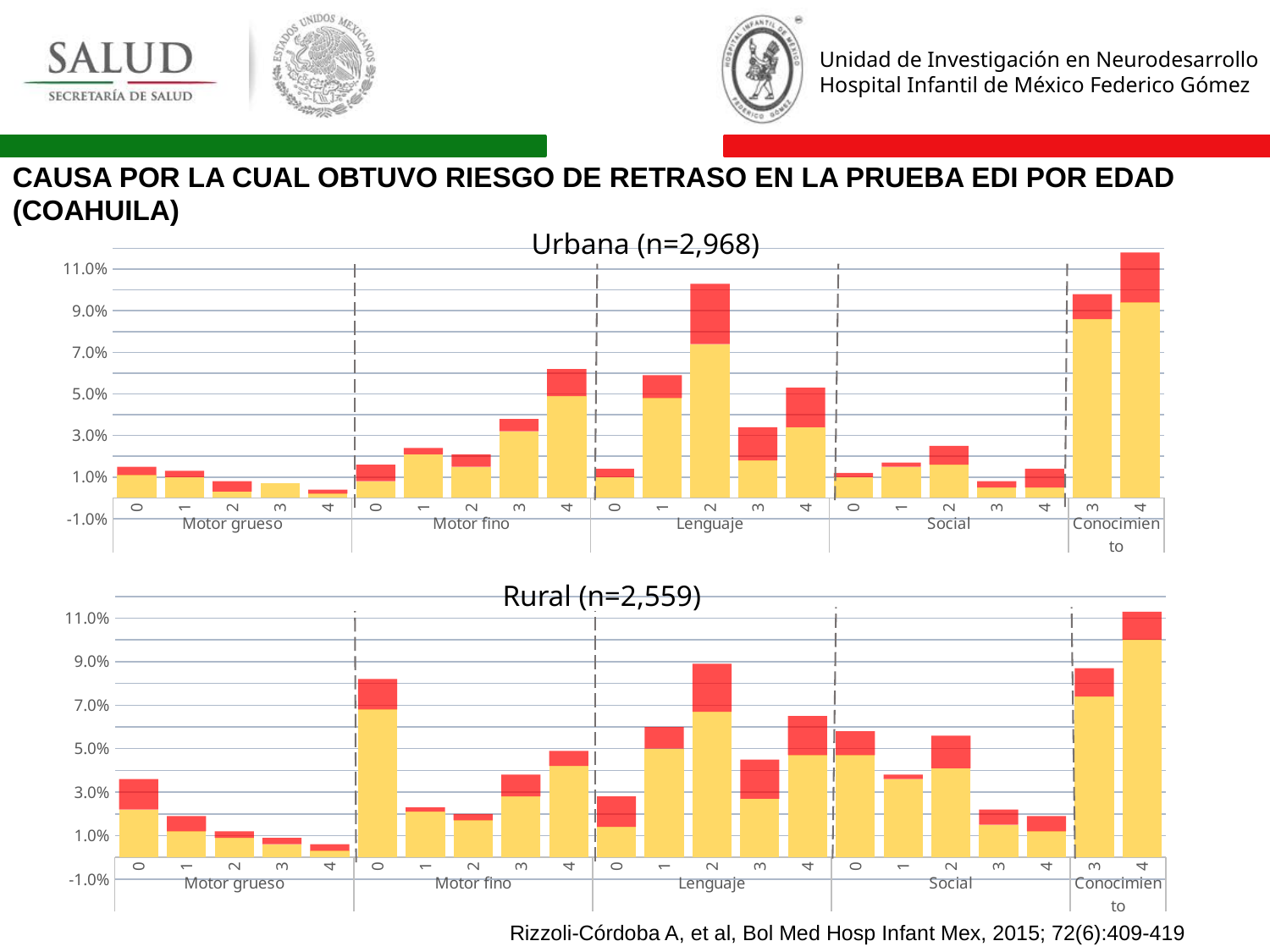
In the Urbana chart, is the total value for Lenguaje age 2 greater or less than 9.0%? greater What is the sample size shown in the title of the Rural chart? n=2,559 In the Urbana (n=2,968) chart, which bar is the lowest? Motor grueso, age 4 In the Rural (n=2,559) chart, which bar is the highest? Conocimiento, age 4 In the Urbana chart, do the Motor grueso bars rise or fall from age 0 to age 4? fall How many domain groups (Motor grueso, Motor fino, etc.) are shown along the x axis of the Urbana chart? 5 In the Urbana chart, which is larger: the bar for Lenguaje age 2 or the bar for Motor fino age 4? Lenguaje age 2 In the Rural chart, is the total value for Motor fino age 0 greater or less than 7.0%? greater In the Rural chart, which is larger: the bar for Motor fino age 0 or the bar for Motor fino age 1? Motor fino age 0 In the Urbana (n=2,968) chart, which bar is the highest? Conocimiento, age 4 How many bars are plotted in the Rural (n=2,559) chart? 22 What kind of chart is the Urbana (n=2,968) chart? Stacked bar chart